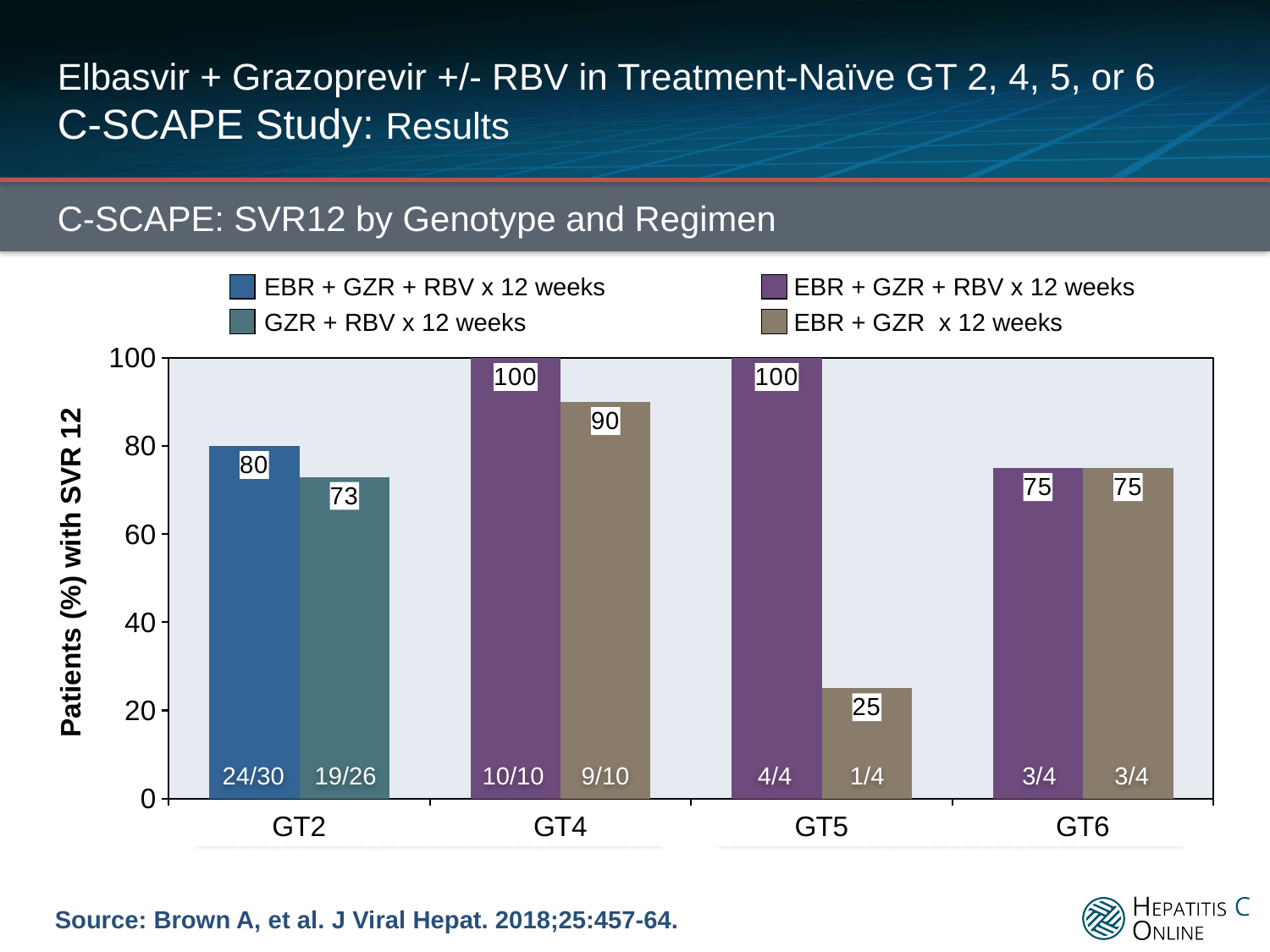
What is the label of the y axis? Patients (%) with SVR 12 What kind of chart is shown on the slide? Bar chart What is the difference in SVR12 rate between the two regimens shown for GT5? 75 What fraction of patients is shown for the EBR + GZR x 12 weeks bar in GT6? 3/4 What is the difference in SVR12 rate between the two regimens shown for GT4? 10 How many genotype categories are shown on the x axis? 4 Which bar has the lowest SVR12 rate on the chart? EBR + GZR x 12 weeks in GT5 (25) What is the SVR12 rate (%) for the EBR + GZR + RBV x 12 weeks regimen in GT2? 80 What is the SVR12 rate (%) for the EBR + GZR x 12 weeks regimen in GT5? 25 How many patients achieved SVR12 with GZR + RBV x 12 weeks in GT2, as shown at the base of the bar? 19/26 How many entries does the legend list? 4 In GT2, which regimen has the higher SVR12 rate: EBR + GZR + RBV x 12 weeks or GZR + RBV x 12 weeks? EBR + GZR + RBV x 12 weeks